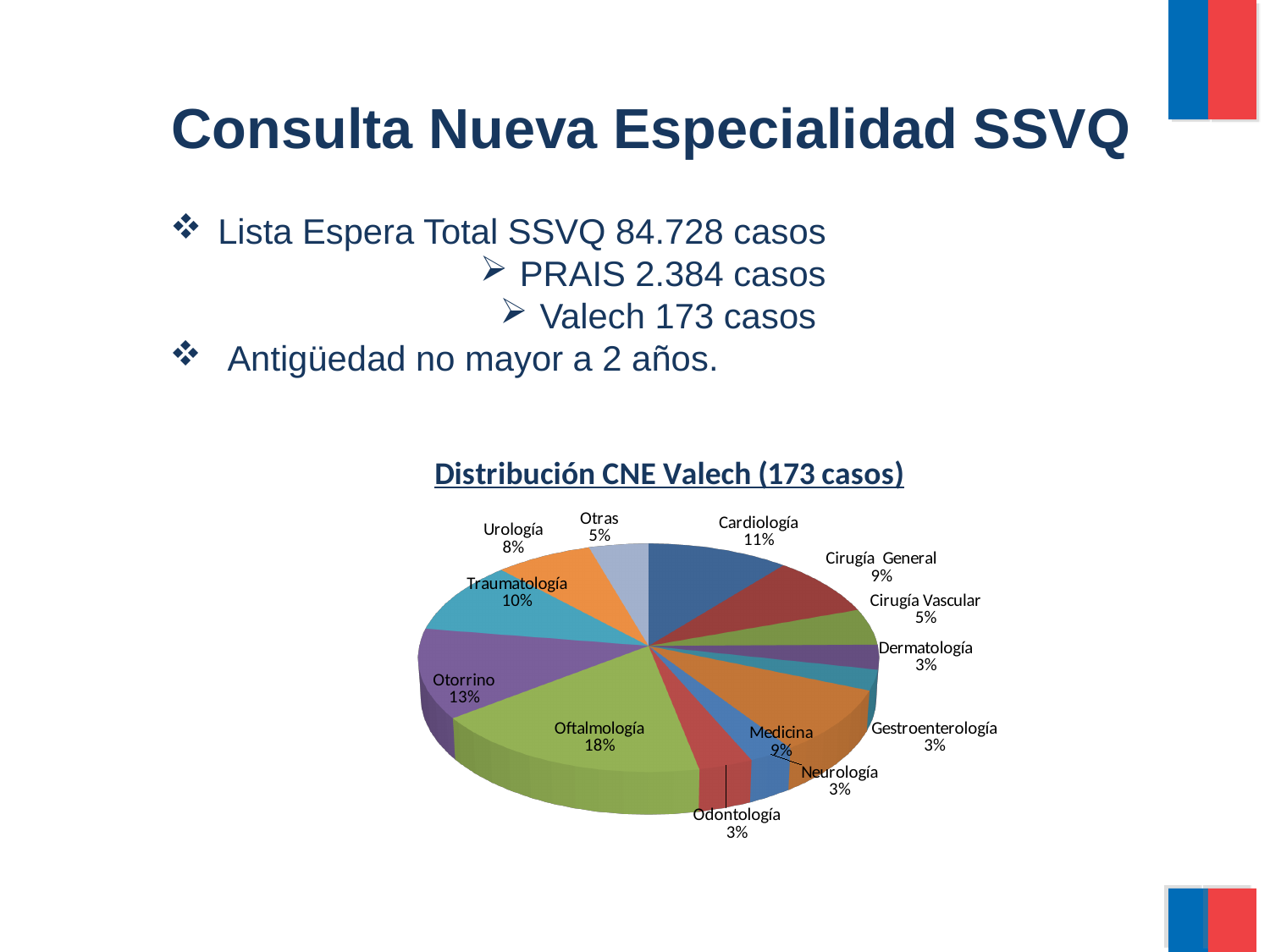
What type of chart is shown on the slide? pie chart What percentage is shown for Traumatología? 10% What is the combined percentage of Cardiología and Medicina? 20% How many slices does the pie chart have? 13 Which is larger, the share for Cirugía General or the share for Cirugía Vascular? Cirugía General What percentage is shown for Cardiología? 11% What is the title of the chart? Distribución CNE Valech (173 casos) Which specialty has the largest slice of the pie? Oftalmología What percentage is shown for Urología? 8% What is the difference in percentage points between Oftalmología and Otorrino? 5 What share of the pie does Oftalmología represent? 18% What percentage is shown for Otorrino? 13%